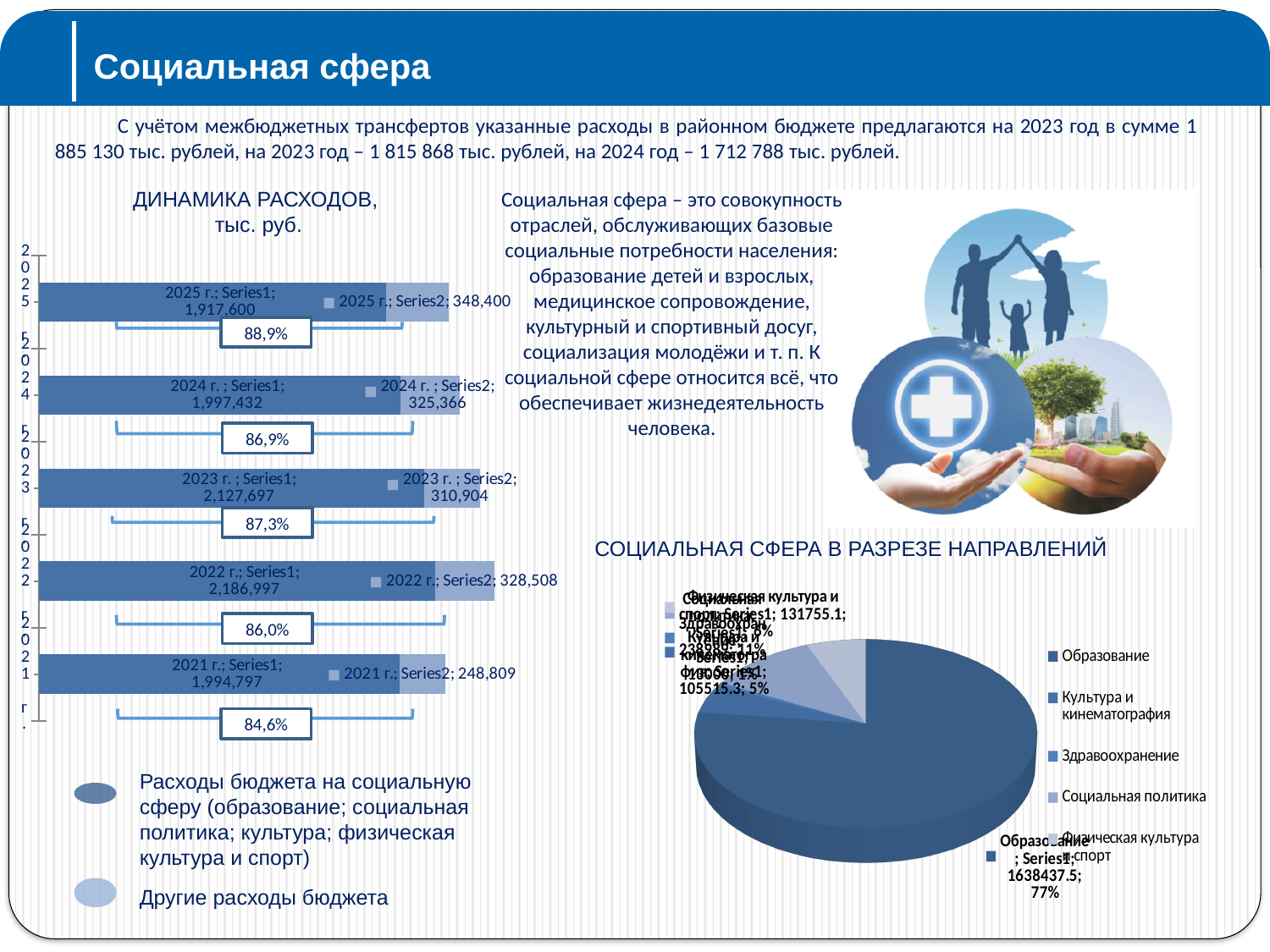
What kind of chart is the 'ДИНАМИКА РАСХОДОВ, тыс. руб.' chart? bar chart In the 'ДИНАМИКА РАСХОДОВ, тыс. руб.' chart, which year has the lowest Series2 value? 2021 г. In the 'ДИНАМИКА РАСХОДОВ, тыс. руб.' chart, which year has the highest Series1 value? 2022 г. In the 'ДИНАМИКА РАСХОДОВ, тыс. руб.' chart, what is the difference between the Series1 values for 2022 г. and 2025 г.? 269,397 In the 'СОЦИАЛЬНАЯ СФЕРА В РАЗРЕЗЕ НАПРАВЛЕНИЙ' pie chart, what share does Образование have? 77% How many years are shown in the 'ДИНАМИКА РАСХОДОВ, тыс. руб.' chart? 5 In the 'ДИНАМИКА РАСХОДОВ, тыс. руб.' chart, what is the Series1 value for 2025 г.? 1,917,600 In the 'ДИНАМИКА РАСХОДОВ, тыс. руб.' chart, which year has the larger Series2 value, 2025 г. or 2024 г.? 2025 г. In the 'ДИНАМИКА РАСХОДОВ, тыс. руб.' chart, what is the total of the stacked bar for 2024 г.? 2,322,798 What kind of chart is the 'СОЦИАЛЬНАЯ СФЕРА В РАЗРЕЗЕ НАПРАВЛЕНИЙ' chart? pie chart In the 'ДИНАМИКА РАСХОДОВ, тыс. руб.' chart, what is the Series2 value for 2023 г.? 310,904 How many entries does the legend of the 'СОЦИАЛЬНАЯ СФЕРА В РАЗРЕЗЕ НАПРАВЛЕНИЙ' pie chart list? 5